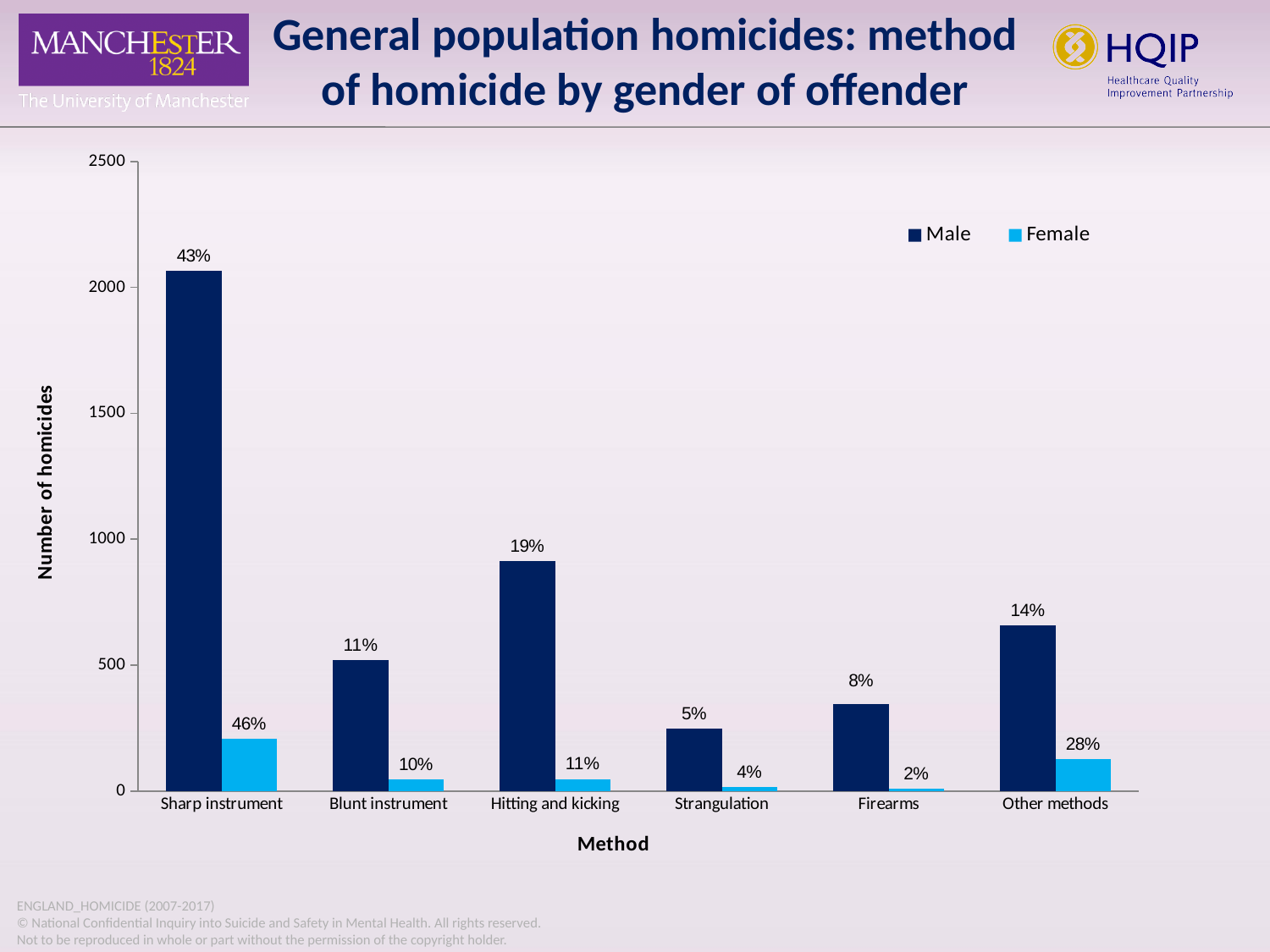
How many methods are shown on the x axis? 6 Which is larger: the Male bar for Hitting and kicking or the Male bar for Other methods? Hitting and kicking What percentage label is shown on the Male bar for Hitting and kicking? 19% Which method has the tallest Male bar? Sharp instrument What kind of chart is shown on the slide? Bar chart Is the number of homicides for Male Hitting and kicking greater or less than 1000? less What percentage label is shown on the Female bar for Other methods? 28% What percentage label is shown on the Male bar for Sharp instrument? 43% Is the number of homicides for Male Sharp instrument greater or less than 2000? greater How many series does the legend list? 2 What percentage label is shown on the Female bar for Firearms? 2% Which method has the shortest Female bar? Firearms